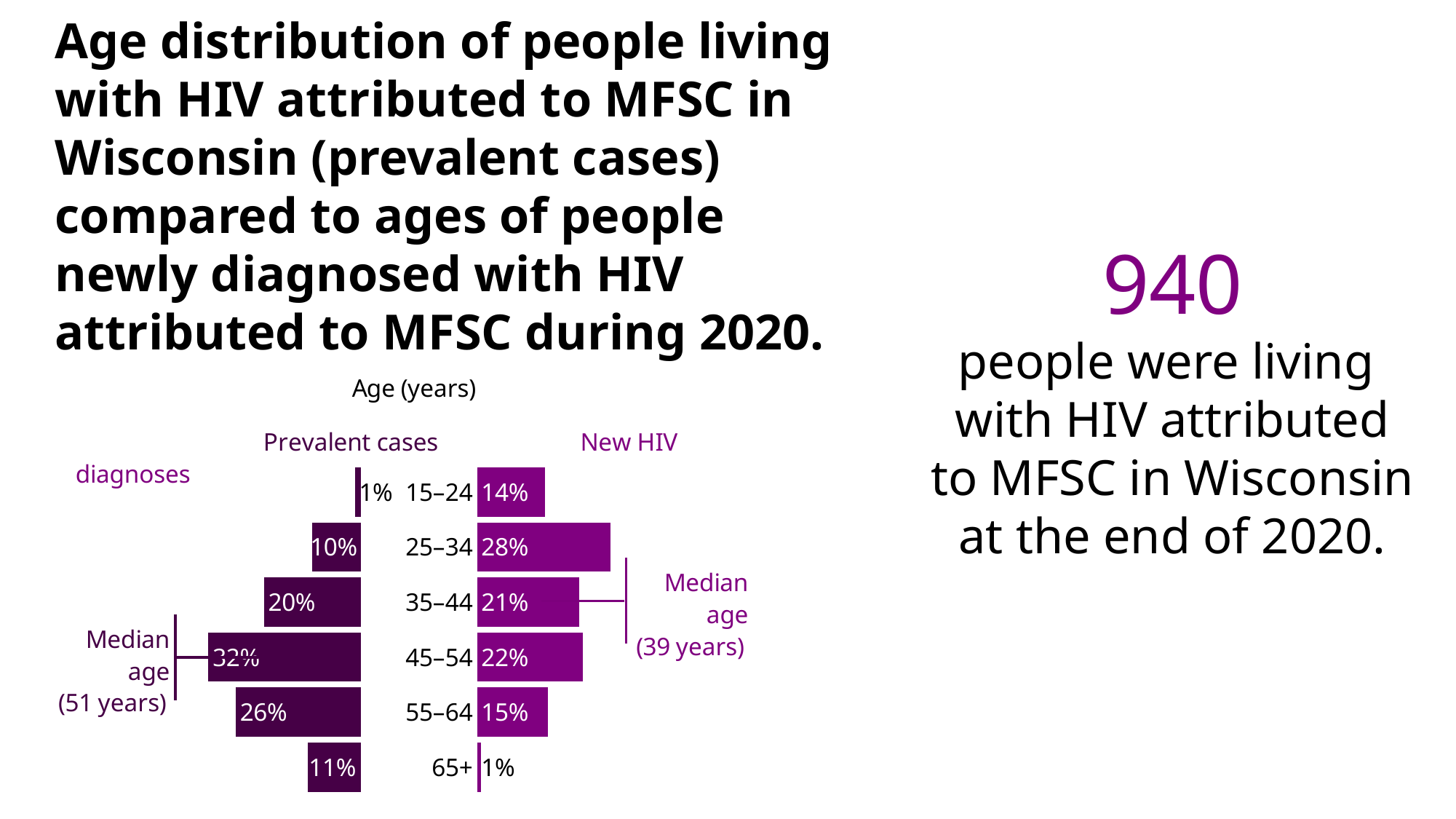
What is the median age of people newly diagnosed with HIV according to the chart? 39 years How many age groups are shown on the chart? 6 What type of chart is shown on the slide? Bar chart What percentage of prevalent cases are in the 45–54 age group? 32% Which age group has the highest share of new HIV diagnoses? 25–34 What percentage of prevalent cases are in the 15–24 age group? 1% For the 35–44 age group, which is larger: the share of prevalent cases or the share of new HIV diagnoses? New HIV diagnoses What is the difference between the prevalent cases share and the new HIV diagnoses share for the 55–64 age group? 11 percentage points How many data series does the chart show? 2 What percentage of new HIV diagnoses are in the 25–34 age group? 28% Which age group has the highest share of prevalent cases? 45–54 Which age group has the lowest share of new HIV diagnoses? 65+